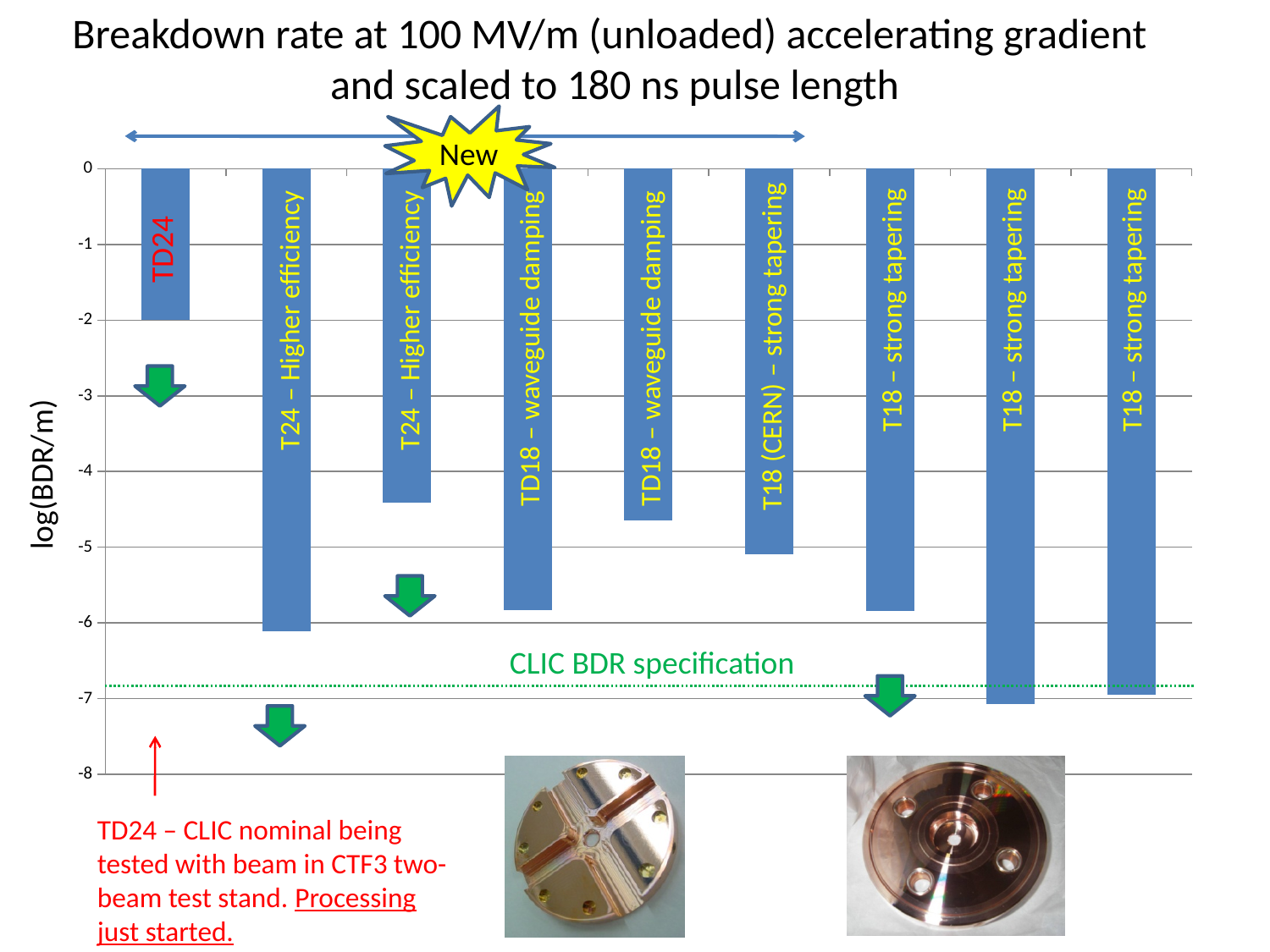
What is the label on the vertical axis of the chart? log(BDR/m) Which has the larger log(BDR/m) value: the TD24 bar or the leftmost 'T24 – Higher efficiency' bar? TD24 Is the value for the leftmost 'TD18 – waveguide damping' bar greater or less than -5? less Is the value for the leftmost 'T24 – Higher efficiency' bar greater or less than -5? less How many bars are plotted in the chart? 9 Is the value for the 'T18 (CERN) – strong tapering' bar greater or less than -4? less Which bar has the highest (least negative) log(BDR/m) value? TD24 Which has the larger log(BDR/m) value: the 'T24 – Higher efficiency' bar marked 'New' or the leftmost 'TD18 – waveguide damping' bar? T24 – Higher efficiency (New) What kind of chart is shown on the slide? bar chart What does the green dotted horizontal line in the chart represent? CLIC BDR specification